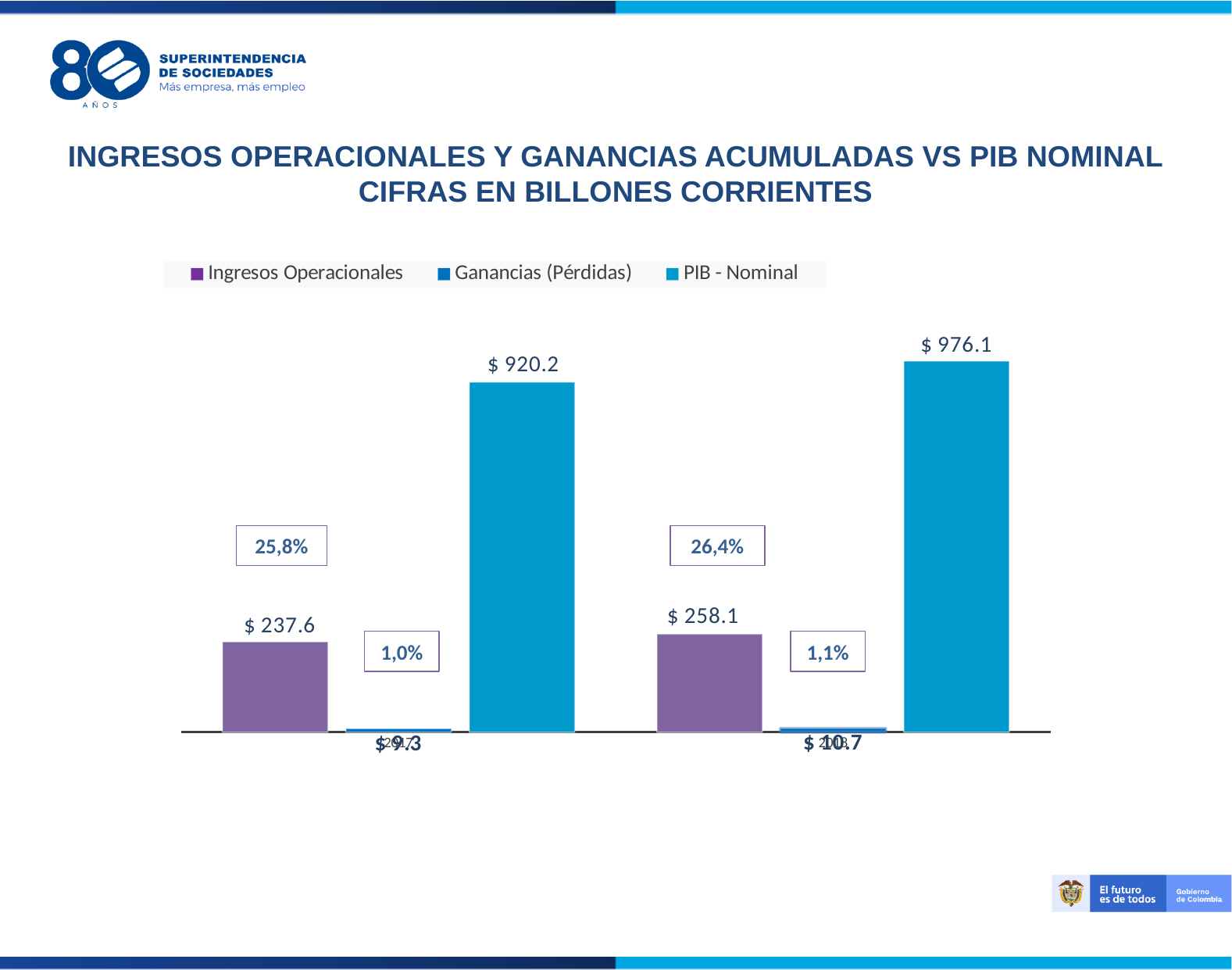
How many groups of bars are plotted along the x axis? 2 What kind of chart is shown on the slide? bar chart What is the value of PIB - Nominal in the right group of bars? $ 976.1 Which series has the tallest bars in the chart? PIB - Nominal What is the value of Ingresos Operacionales in the left group of bars? $ 237.6 What is the value of Ganancias (Pérdidas) in the right group of bars? $ 10.7 What is the value of Ingresos Operacionales in the right group of bars? $ 258.1 What is the value of PIB - Nominal in the left group of bars? $ 920.2 Does the value of Ingresos Operacionales rise or fall from the left group to the right group? rise How many series does the legend list? 3 By how much does PIB - Nominal in the right group exceed PIB - Nominal in the left group? $ 55.9 What is the difference between Ingresos Operacionales in the right group and in the left group? $ 20.5